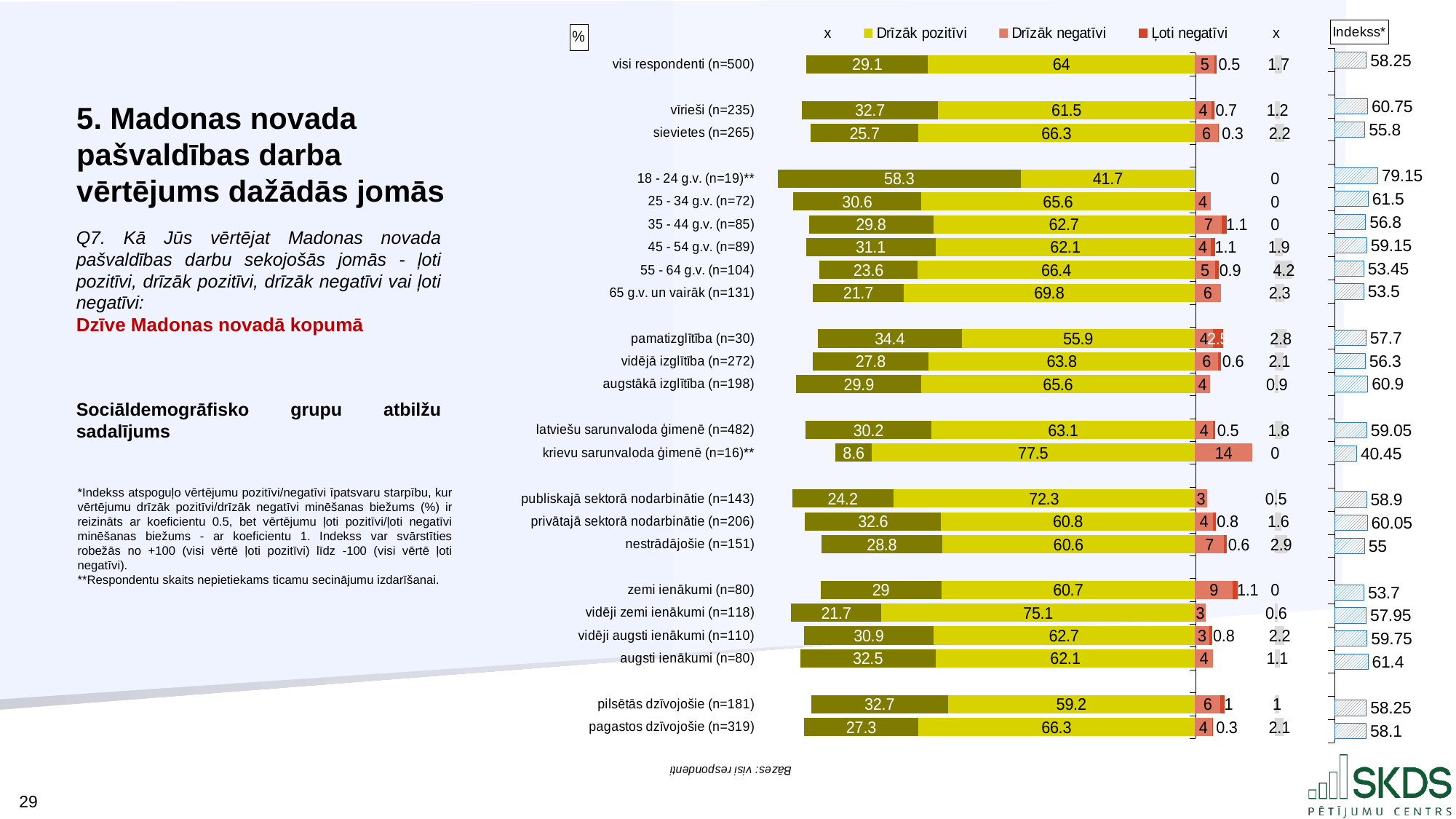
How many respondent groups (bars) are shown in the chart? 23 How many entries does the legend list? 5 What is the Drīzāk negatīvi value for zemi ienākumi (n=80)? 9 Which group has the lowest Indekss* value? krievu sarunvaloda ģimenē (n=16)** What is the Indekss* value for visi respondenti (n=500)? 58.25 Which group has the highest Indekss* value? 18 - 24 g.v. (n=19)** Which has a higher Indekss* value: publiskajā sektorā nodarbinātie (n=143) or privātajā sektorā nodarbinātie (n=206)? privātajā sektorā nodarbinātie (n=206) Which group has the largest Drīzāk negatīvi share? krievu sarunvaloda ģimenē (n=16)** What is the difference between the Drīzāk pozitīvi values for pagastos dzīvojošie (n=319) and pilsētās dzīvojošie (n=181)? 7.1 What kind of chart is used to show the ratings by sociodemographic group? stacked bar chart What is the difference between the Indekss* values for vīrieši (n=235) and sievietes (n=265)? 4.95 What is the Drīzāk pozitīvi value for krievu sarunvaloda ģimenē (n=16)**? 77.5